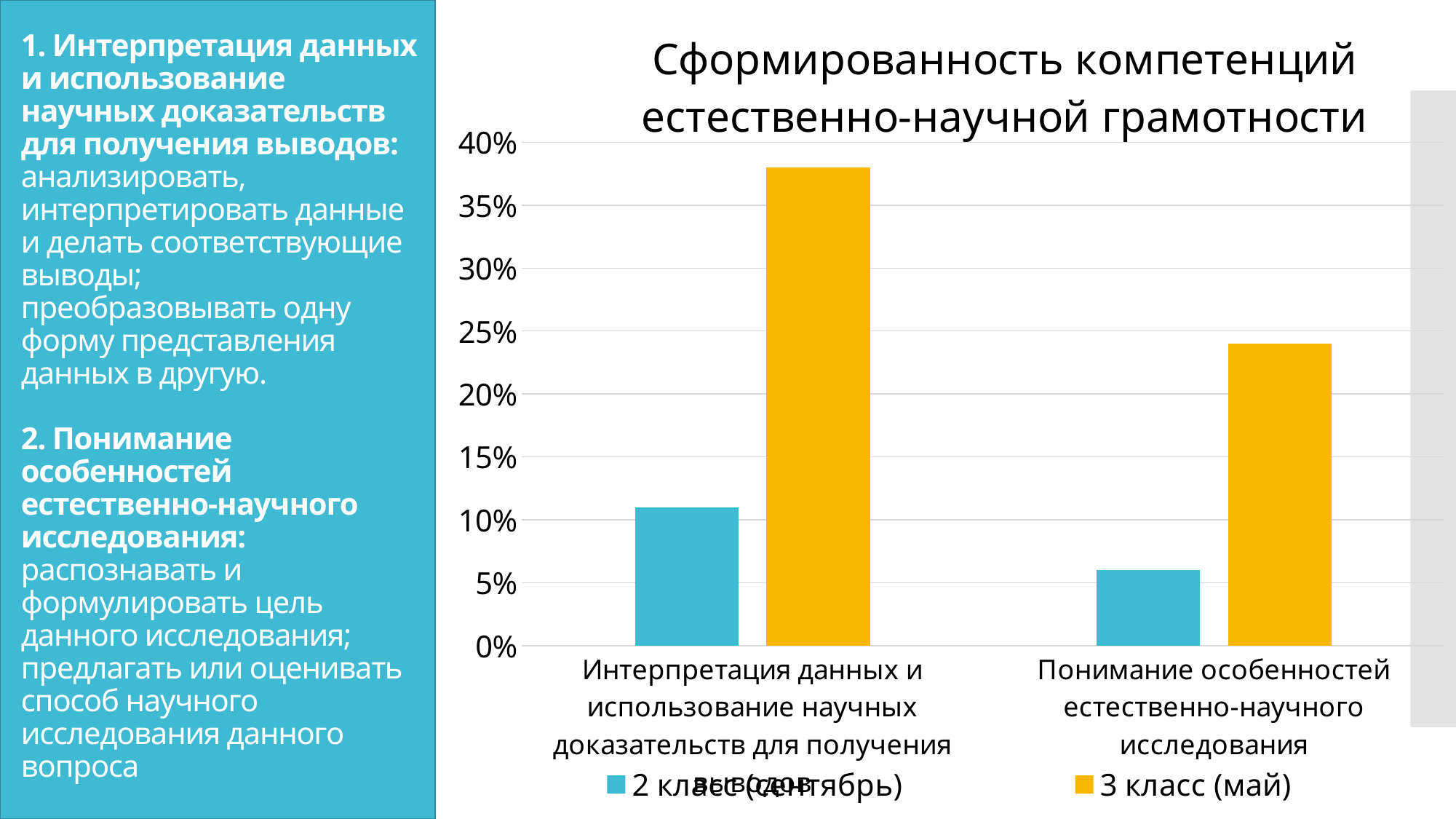
Is the value for 3 класс (май) in the category 'Интерпретация данных и использование научных доказательств для получения выводов' greater or less than 35%? greater Which series has the higher value in the category 'Понимание особенностей естественно-научного исследования'? 3 класс (май) In which category does the 3 класс (май) series reach its highest value? Интерпретация данных и использование научных доказательств для получения выводов Is the value for 3 класс (май) in the category 'Понимание особенностей естественно-научного исследования' greater or less than 20%? greater Which bar is the lowest on the chart? 2 класс (сентябрь) in Понимание особенностей естественно-научного исследования What kind of chart is shown on the slide? bar chart Is the value for 2 класс (сентябрь) in the category 'Интерпретация данных и использование научных доказательств для получения выводов' greater or less than 15%? less What is the title of the chart? Сформированность компетенций естественно-научной грамотности Which series is shown in orange? 3 класс (май) How many series does the legend list? 2 How many categories are shown on the x axis? 2